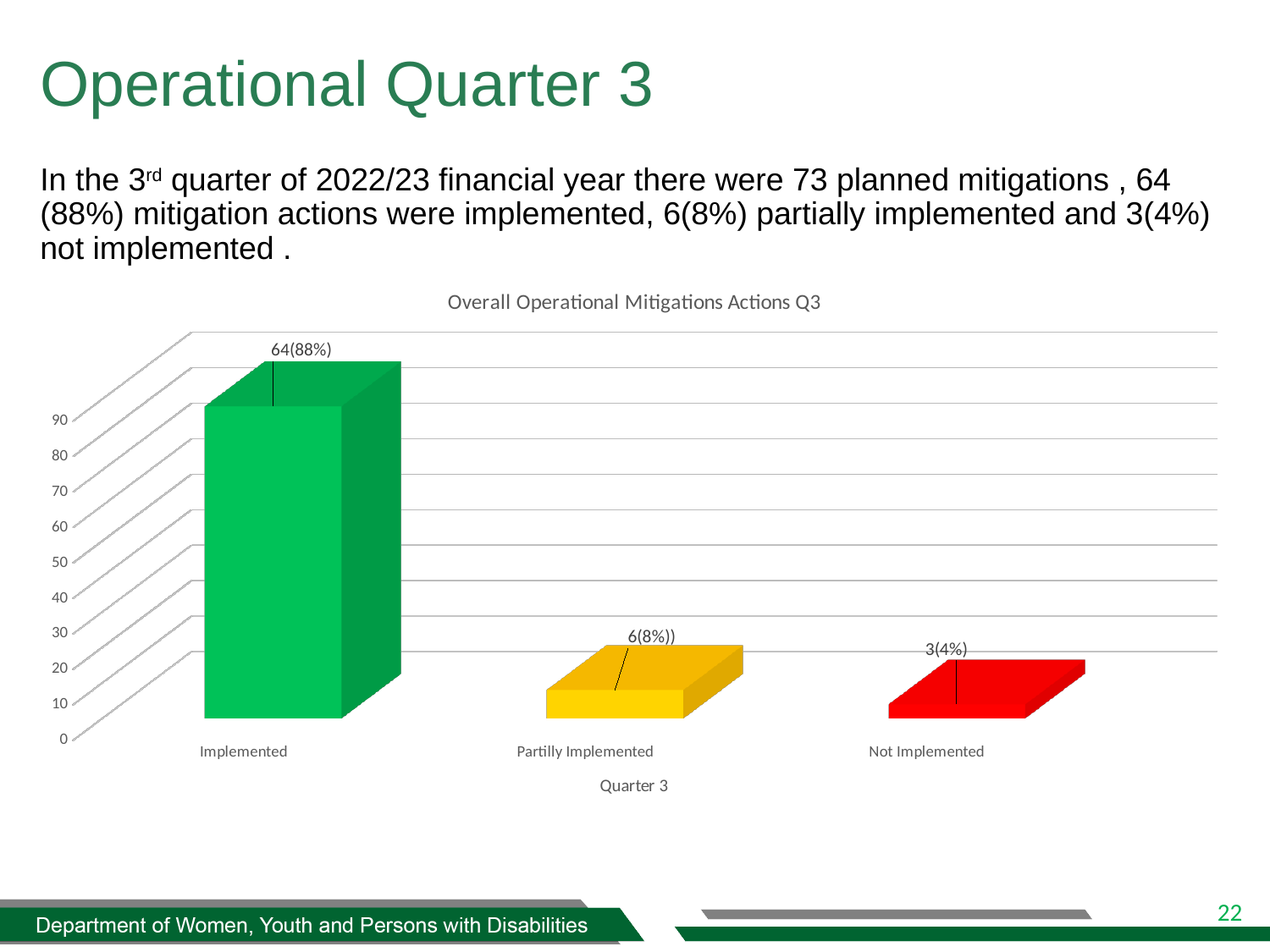
What type of chart is shown on the slide? Bar chart What is the difference between the number of Partilly Implemented and Not Implemented mitigation actions? 3 How many categories are plotted on the chart? 3 What is the data label shown for the Partilly Implemented bar? 6(8%)) What is the title of the chart? Overall Operational Mitigations Actions Q3 What is the x-axis title of the chart? Quarter 3 What is the difference between the number of Implemented and Not Implemented mitigation actions? 61 Which category has the highest value? Implemented What is the data label shown for the Implemented bar? 64(88%) What is the data label shown for the Not Implemented bar? 3(4%) Which category has the lowest value? Not Implemented Which is larger, the value for Partilly Implemented or the value for Not Implemented? Partilly Implemented